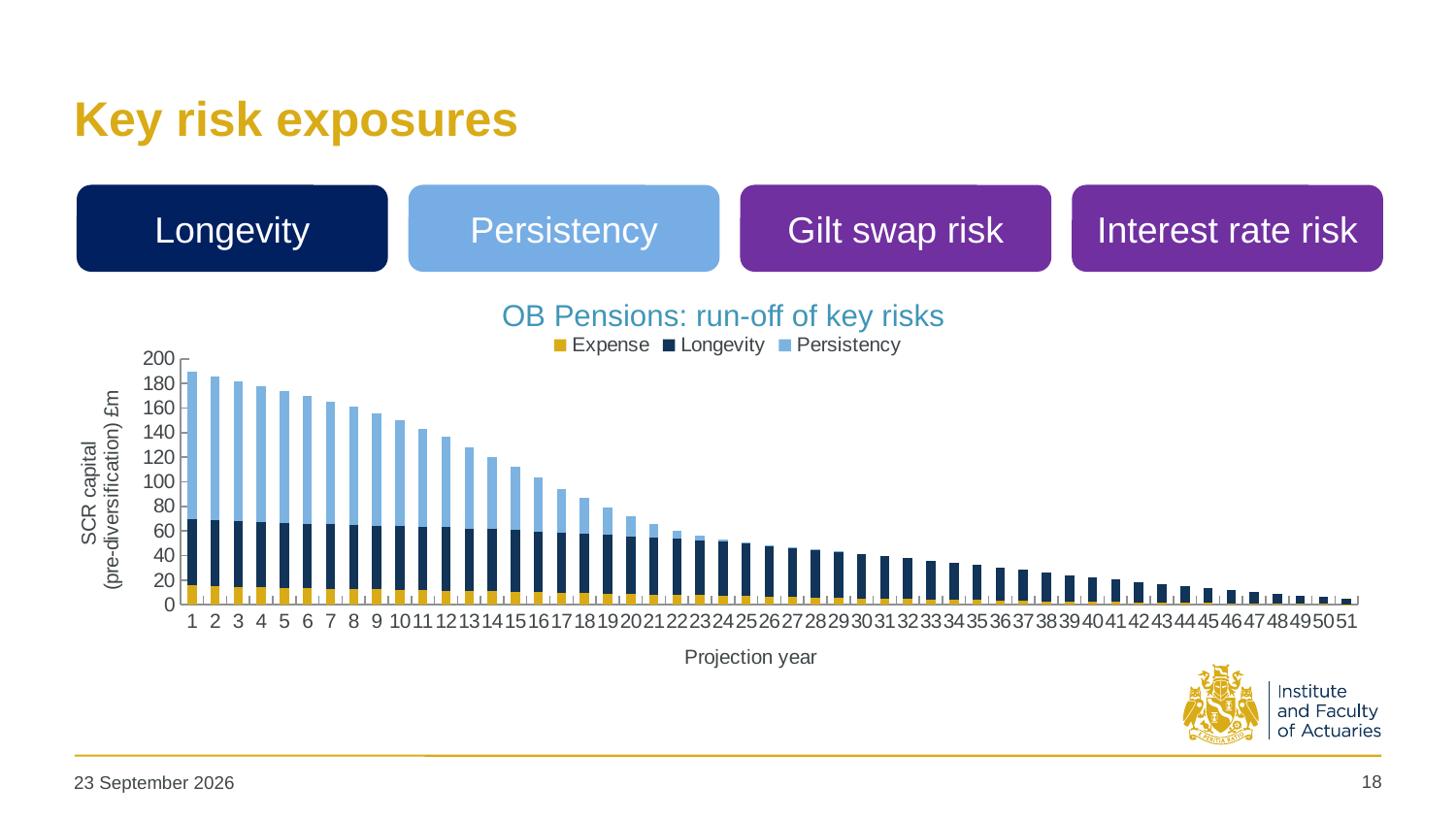
Which projection year has the highest total SCR capital? 1 Is the total SCR capital for projection year 51 greater or less than 20? less Do the total SCR capital values rise or fall as the projection year increases? Fall Is the total SCR capital for projection year 30 greater or less than 60? less Which projection year has the lowest total SCR capital? 51 Which series are listed in the chart legend? Expense, Longevity, Persistency Is the total SCR capital for projection year 1 greater or less than 180? greater What is the title of the chart? OB Pensions: run-off of key risks How many projection years are plotted on the x axis? 51 What kind of chart is shown on the slide? Stacked bar chart How many series does the chart legend list? 3